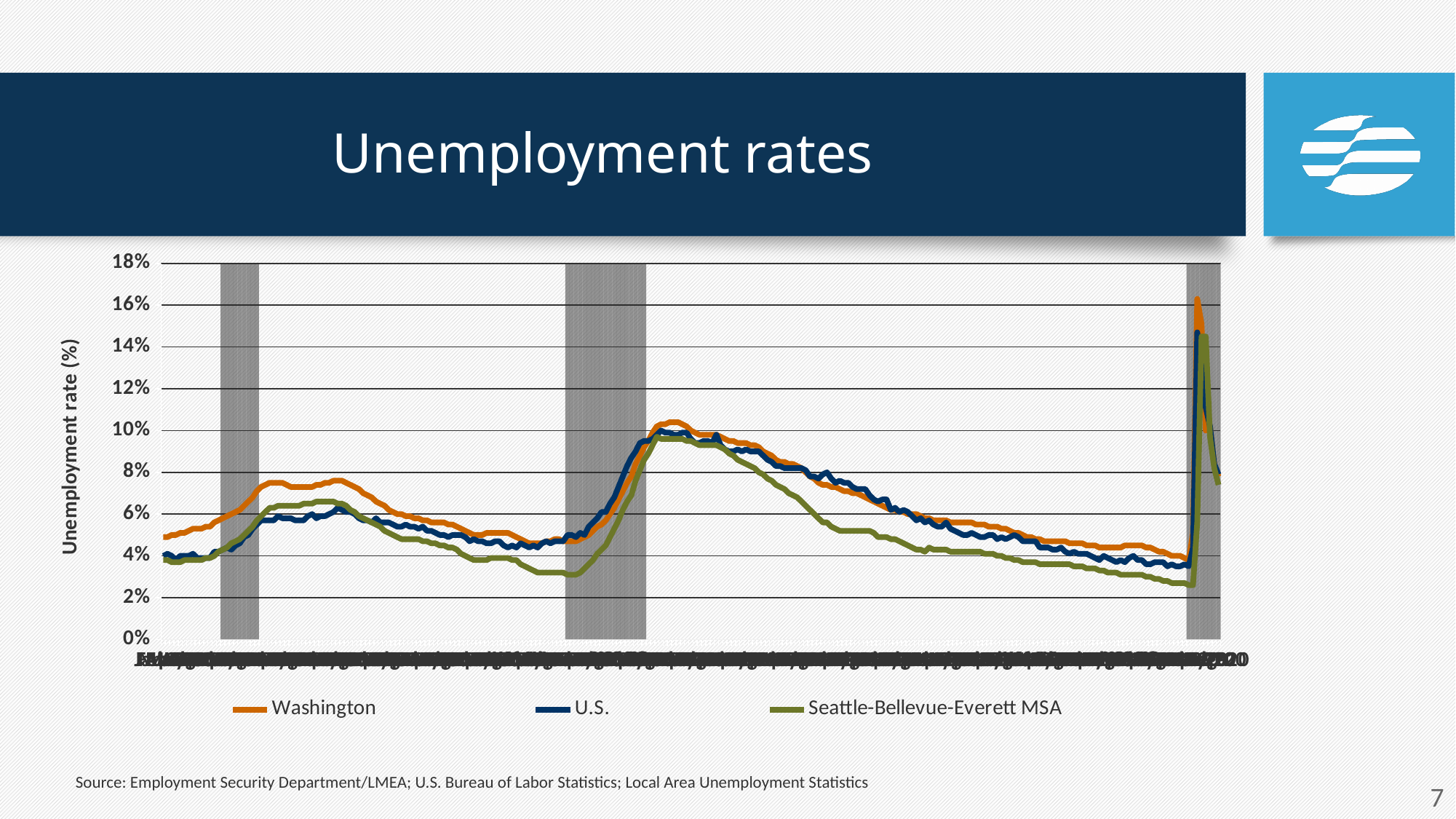
What is the title of the chart? Unemployment rates What is the highest value shown on the vertical axis? 18% What kind of chart is shown on the slide? line chart Is the peak value of the Washington series greater or less than 14%? greater Is the peak value of the U.S. series greater or less than 16%? less Which series reaches the highest peak on the chart? Washington What is the label on the vertical axis? Unemployment rate (%) Is the peak value of the U.S. series greater or less than 12%? greater At the sharp spike near the right end of the chart, which series reaches a higher peak, Washington or U.S.? Washington How many series does the legend list? 3